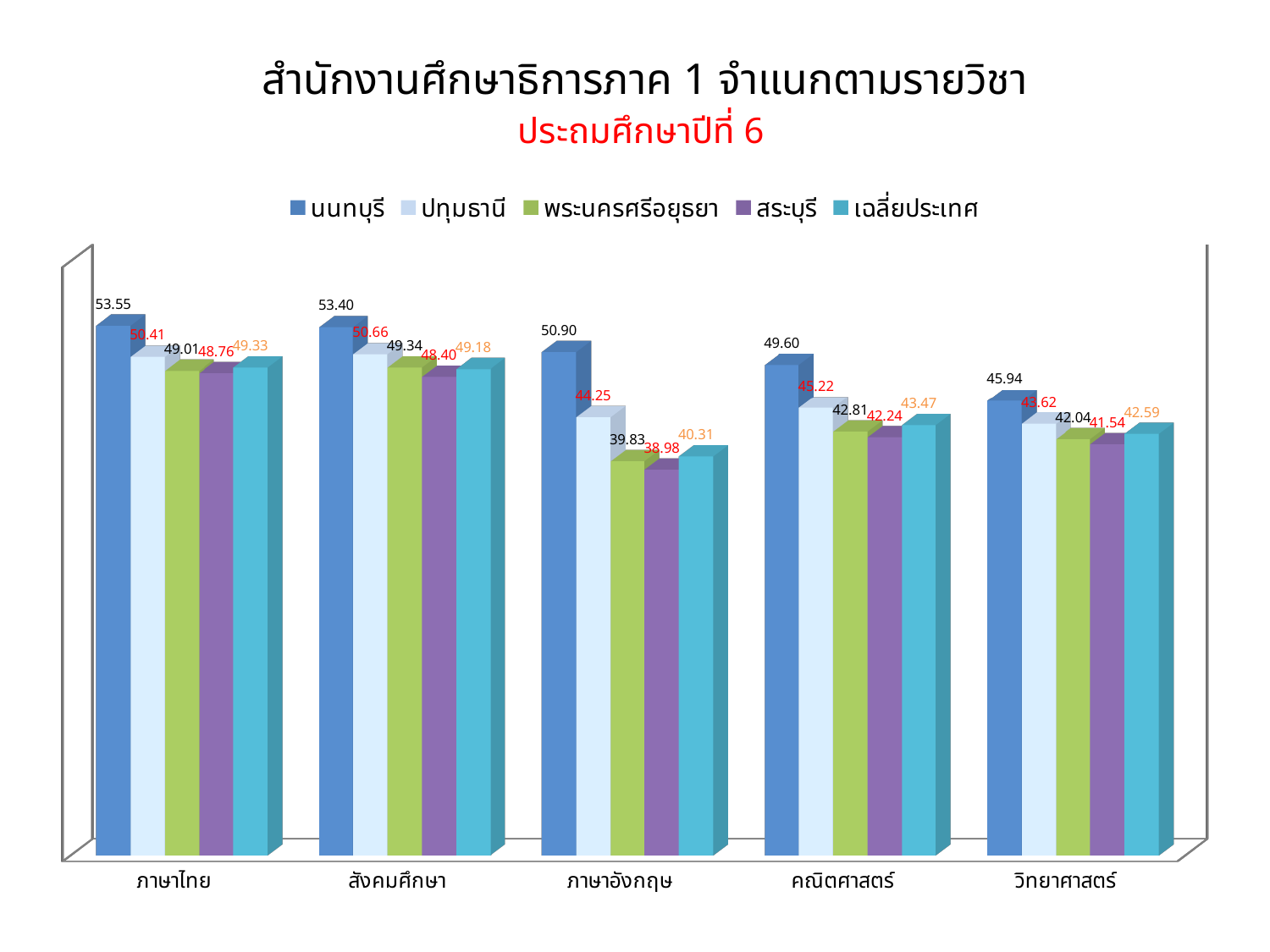
What kind of chart is shown on the slide? Bar chart How many series does the legend list? 5 Which is larger in สังคมศึกษา: the value for พระนครศรีอยุธยา or the value for สระบุรี? พระนครศรีอยุธยา What is the red subtitle below the chart title? ประถมศึกษาปีที่ 6 Which subject has the highest value for นนทบุรี? ภาษาไทย Which subject has the lowest value for พระนครศรีอยุธยา? ภาษาอังกฤษ What is the value for ปทุมธานี in วิทยาศาสตร์? 43.62 What is the value for สระบุรี in ภาษาอังกฤษ? 38.98 How many subjects are shown on the x axis? 5 What is the value for นนทบุรี in ภาษาไทย? 53.55 What is the value for เฉลี่ยประเทศ in คณิตศาสตร์? 43.47 What is the difference between the นนทบุรี and ปทุมธานี values in ภาษาอังกฤษ? 6.65